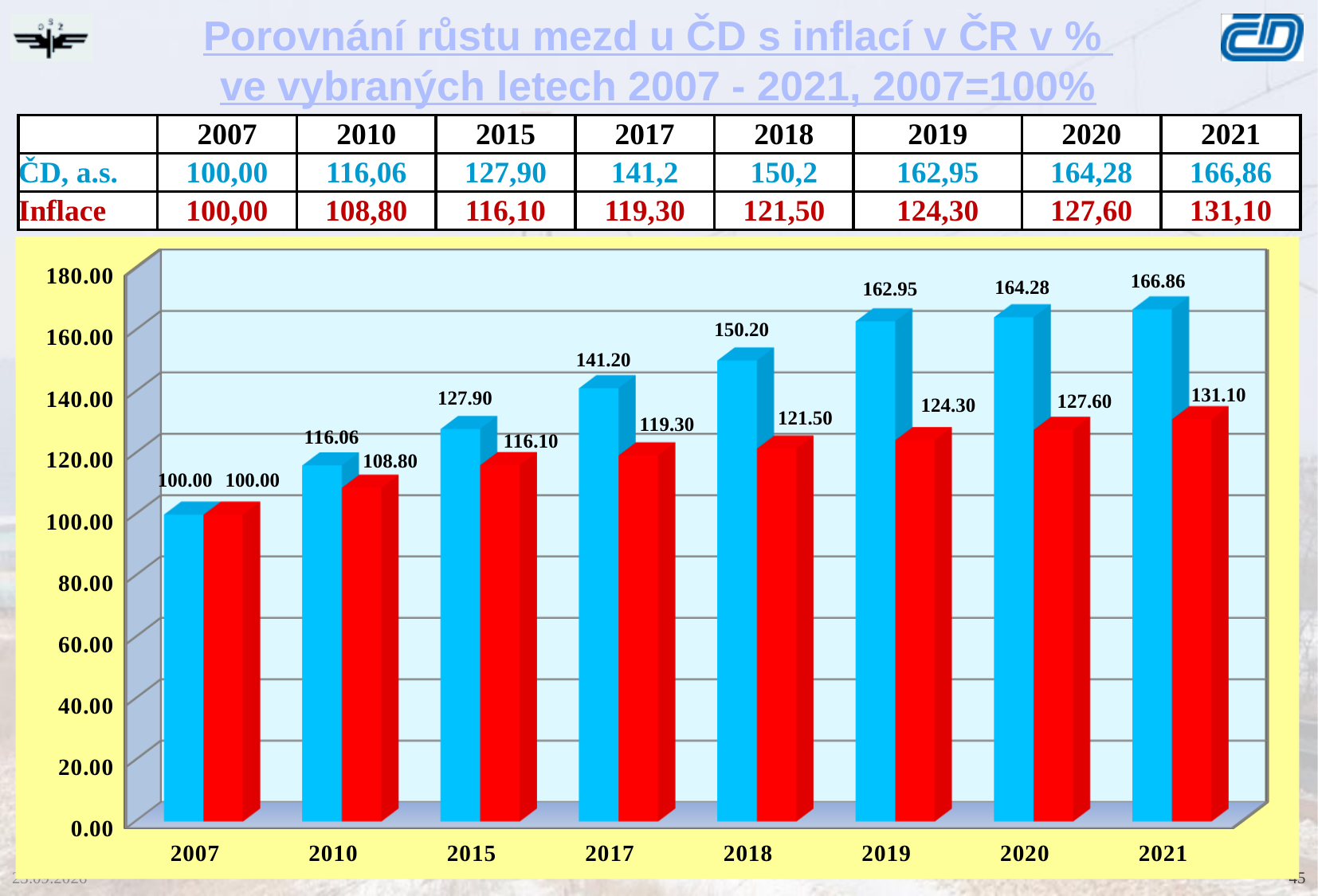
What is the value of the blue (ČD, a.s.) bar for 2015? 127.90 What is the value of the blue (ČD, a.s.) bar for 2018? 150.20 In which year is the red (Inflace) bar lowest? 2007 Do the blue (ČD, a.s.) bars rise or fall from 2007 to 2021? rise In which year is the blue (ČD, a.s.) bar highest? 2021 Is the value of the red (Inflace) bar for 2020 greater or less than 140.00? less Which is larger in 2017: the blue (ČD, a.s.) bar or the red (Inflace) bar? the blue (ČD, a.s.) bar What is the highest tick value shown on the y axis of the chart? 180.00 What is the value of the red (Inflace) bar for 2019? 124.30 How many years are shown on the x axis of the chart? 8 What kind of chart is shown on the slide? bar chart What is the difference between the blue (ČD, a.s.) bar and the red (Inflace) bar in 2021? 35.76